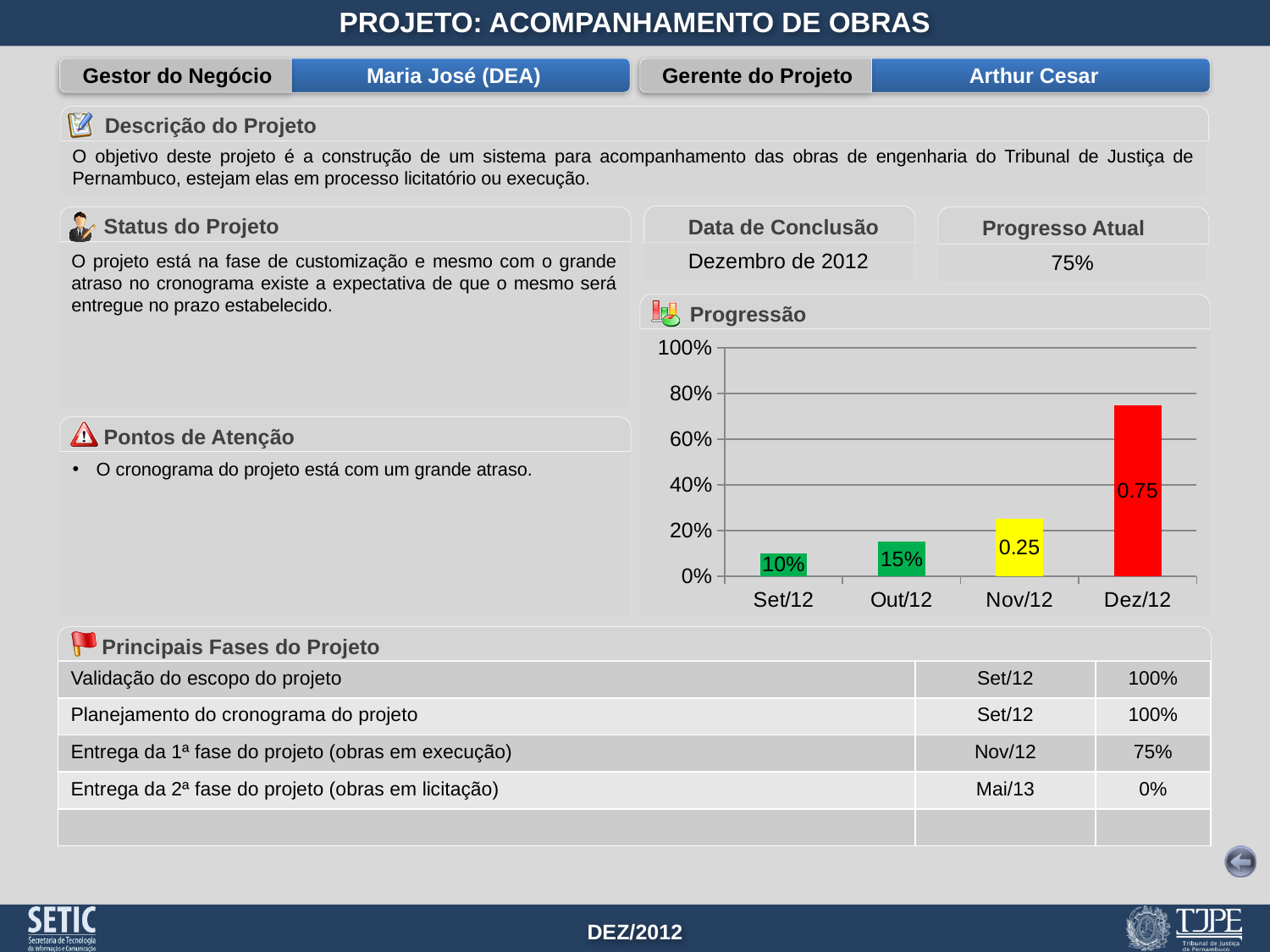
What value is shown for Set/12 in the Progressão chart? 10% Which month has the highest bar in the Progressão chart? Dez/12 Do the values in the Progressão chart rise or fall from Set/12 to Dez/12? rise What is the difference between the values for Out/12 and Set/12 in the Progressão chart? 5% What value is shown for Out/12 in the Progressão chart? 15% What value is labelled on the Dez/12 bar in the Progressão chart? 0.75 Is the value for Dez/12 in the Progressão chart greater or less than 60%? greater Which month has the lowest bar in the Progressão chart? Set/12 What value is labelled on the Nov/12 bar in the Progressão chart? 0.25 Which is larger in the Progressão chart, the bar for Nov/12 or the bar for Out/12? Nov/12 What kind of chart is the Progressão chart? bar chart How many months are shown on the x axis of the Progressão chart? 4